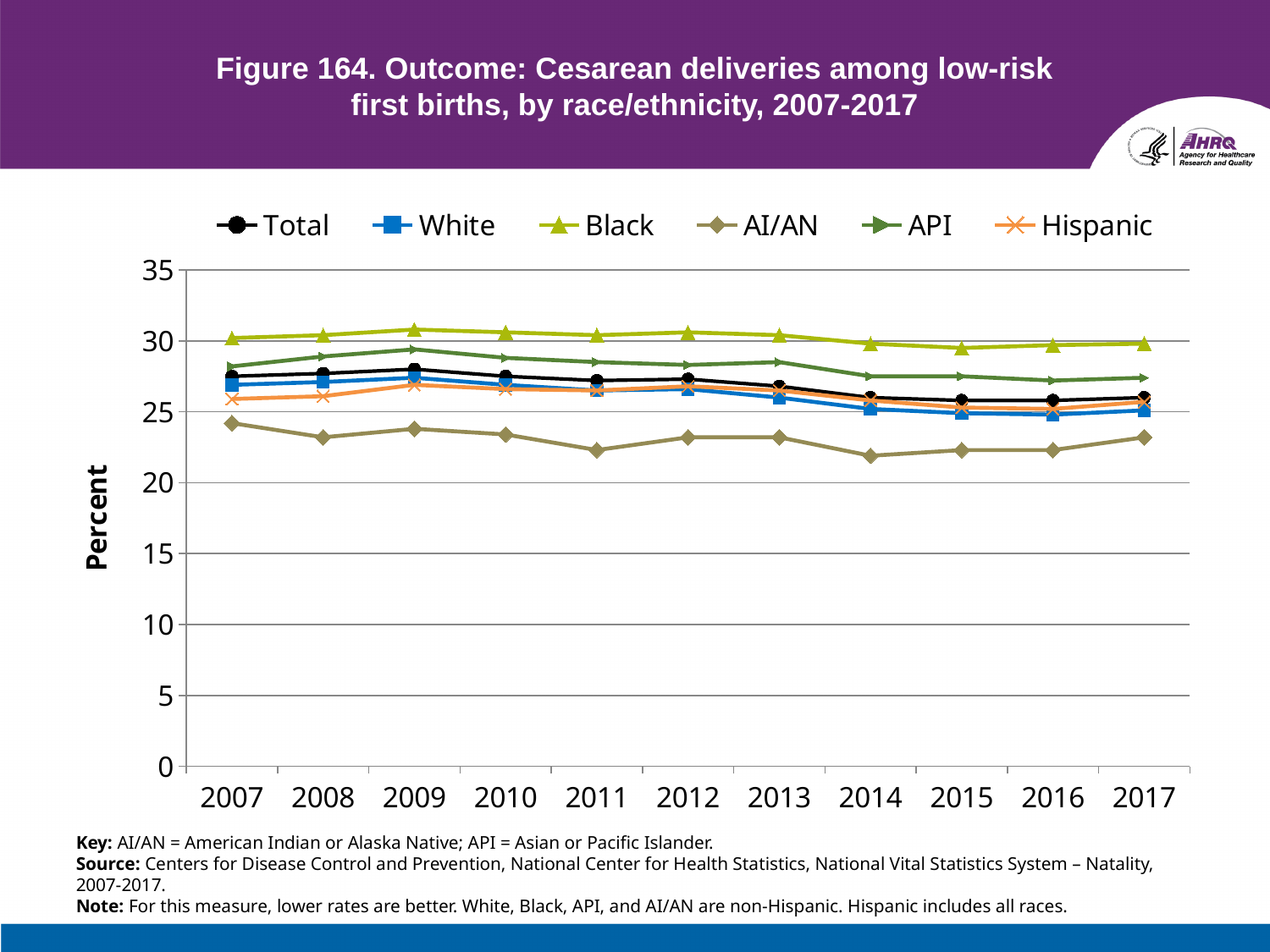
Is the value for Black in 2009 greater or less than 30? greater Does the Total line rise or fall from 2009 to 2017? Fall Is the value for Total in 2007 greater or less than 25? greater How many series does the legend list? 6 Which race/ethnicity group has the lowest cesarean delivery rate in 2014? AI/AN How many years are plotted along the x axis? 11 Which race/ethnicity group has the highest cesarean delivery rate in 2012? Black Which series is shown with triangle markers in the legend? Black What is the label on the y axis? Percent What kind of chart is shown on the slide? Line chart Which is larger in 2017, the value for API or the value for AI/AN? API Is the value for AI/AN in 2014 greater or less than 25? less